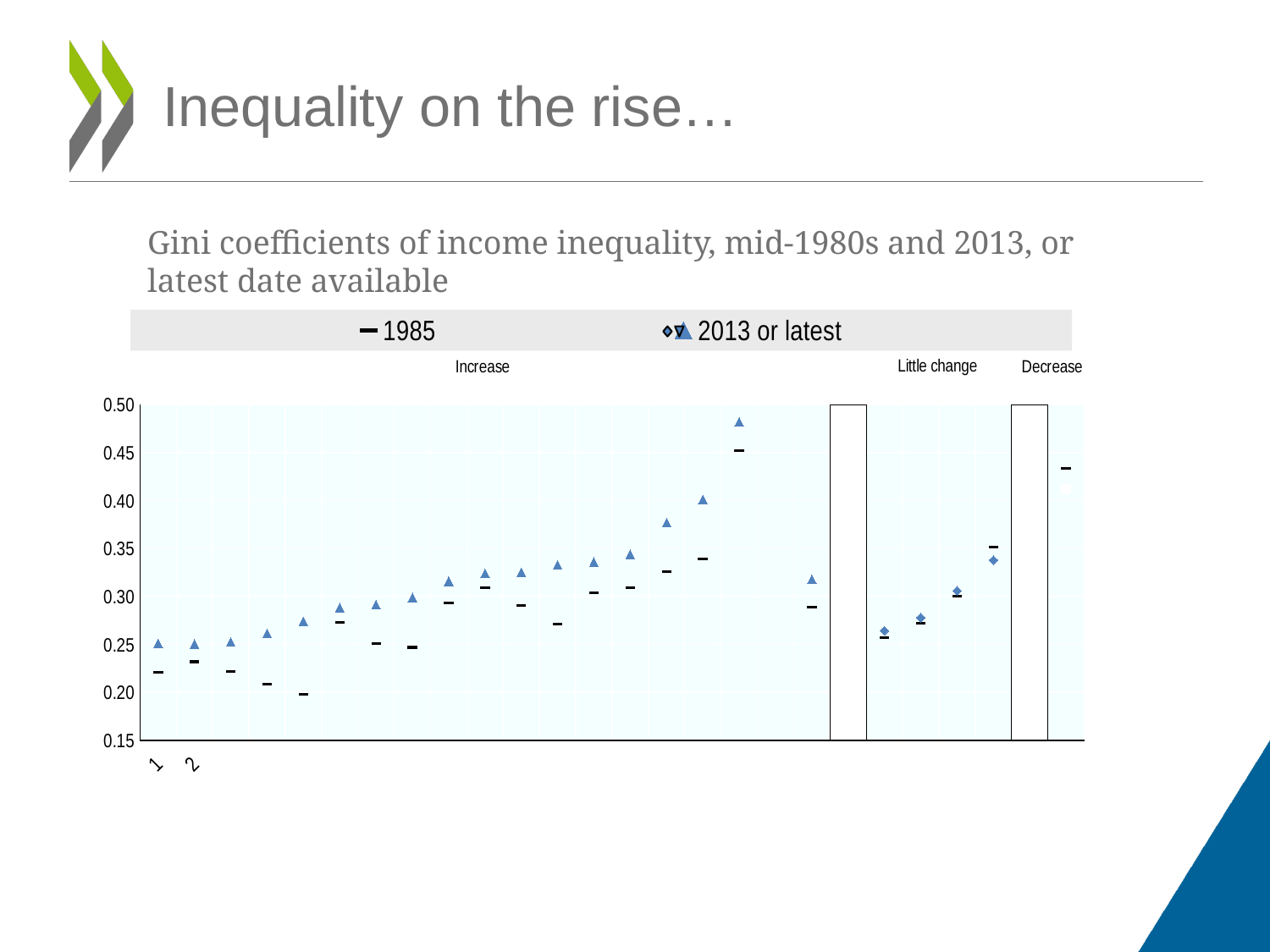
How many series does the legend list? 2 What is the highest value shown on the y axis? 0.50 Within the 'Increase' group, do the 2013 or latest values rise or fall from left to right? rise Is the 1985 value for category 1 greater or less than 0.25? less What are the two series named in the legend? 1985 and 2013 or latest What is the title of the chart? Gini coefficients of income inequality, mid-1980s and 2013, or latest date available What kind of chart is shown on the slide? Scatter (dot) chart Is the 2013 or latest value for category 1 greater or less than 0.30? less How many groups (Increase, Little change, Decrease) is the chart divided into? 3 Is the 1985 value for category 2 greater or less than 0.25? less For category 1, which is larger: the 1985 value or the 2013 or latest value? 2013 or latest